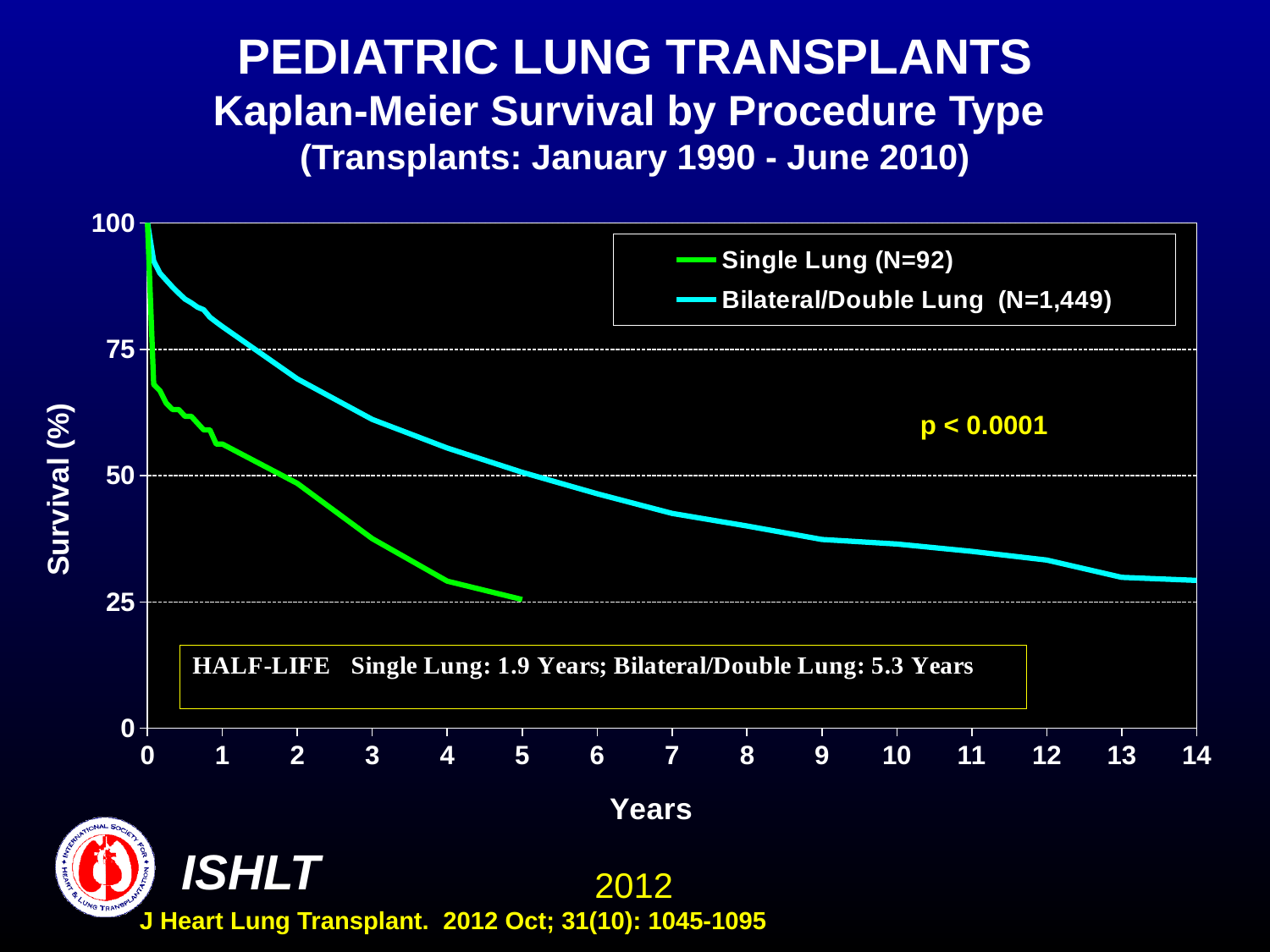
What is the half-life for Single Lung transplants? 1.9 Years Do the survival curves rise or fall as years increase? Fall What is the half-life for Bilateral/Double Lung transplants? 5.3 Years How many series does the legend list? 2 What is the difference in half-life between Bilateral/Double Lung and Single Lung transplants? 3.4 Years Which procedure type has the higher survival curve, Single Lung or Bilateral/Double Lung? Bilateral/Double Lung What p-value is shown on the chart? p < 0.0001 What is the N for the Single Lung group shown in the legend? 92 What is the N for the Bilateral/Double Lung group shown in the legend? 1,449 Is the survival for Single Lung at 4 years greater or less than 50? less Is the survival for Bilateral/Double Lung at 10 years greater or less than 50? less What kind of chart is shown on the slide? Line chart